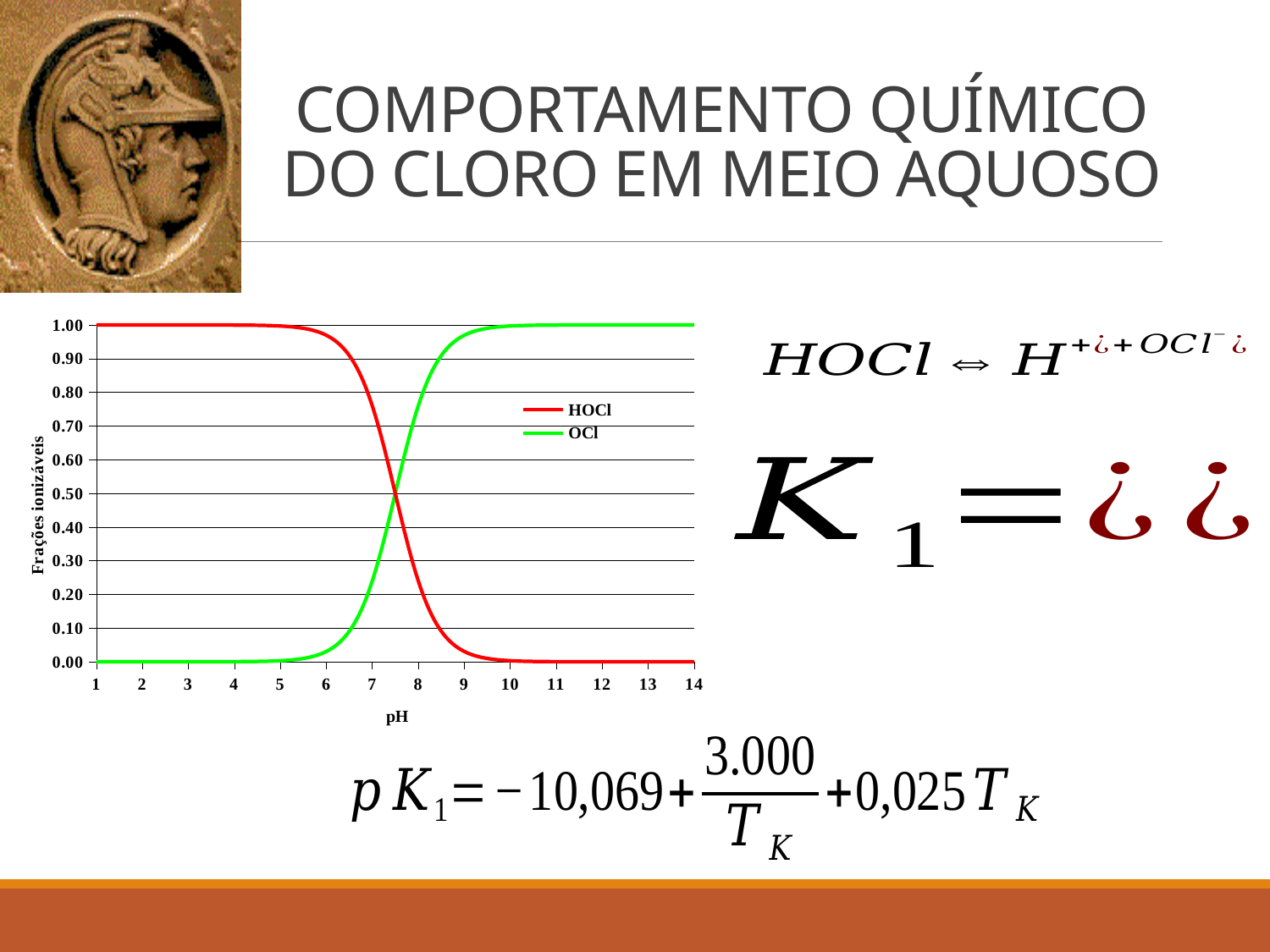
What are the two series named in the chart legend? HOCl and OCl At pH 9, which series has the larger value, HOCl or OCl? OCl Does the HOCl series rise or fall as pH increases? fall What is the label of the x axis of the chart? pH How many pH values are marked along the x axis of the chart? 14 Does the OCl series rise or fall as pH increases? rise Is the value of the HOCl series at pH 9 greater or less than 0.10? less At pH 7, which series has the larger value, HOCl or OCl? HOCl What kind of chart is shown on the slide? line chart How many series does the chart legend list? 2 Is the value of the OCl series at pH 6 greater or less than 0.10? less Is the value of the HOCl series at pH 5 greater or less than 0.90? greater